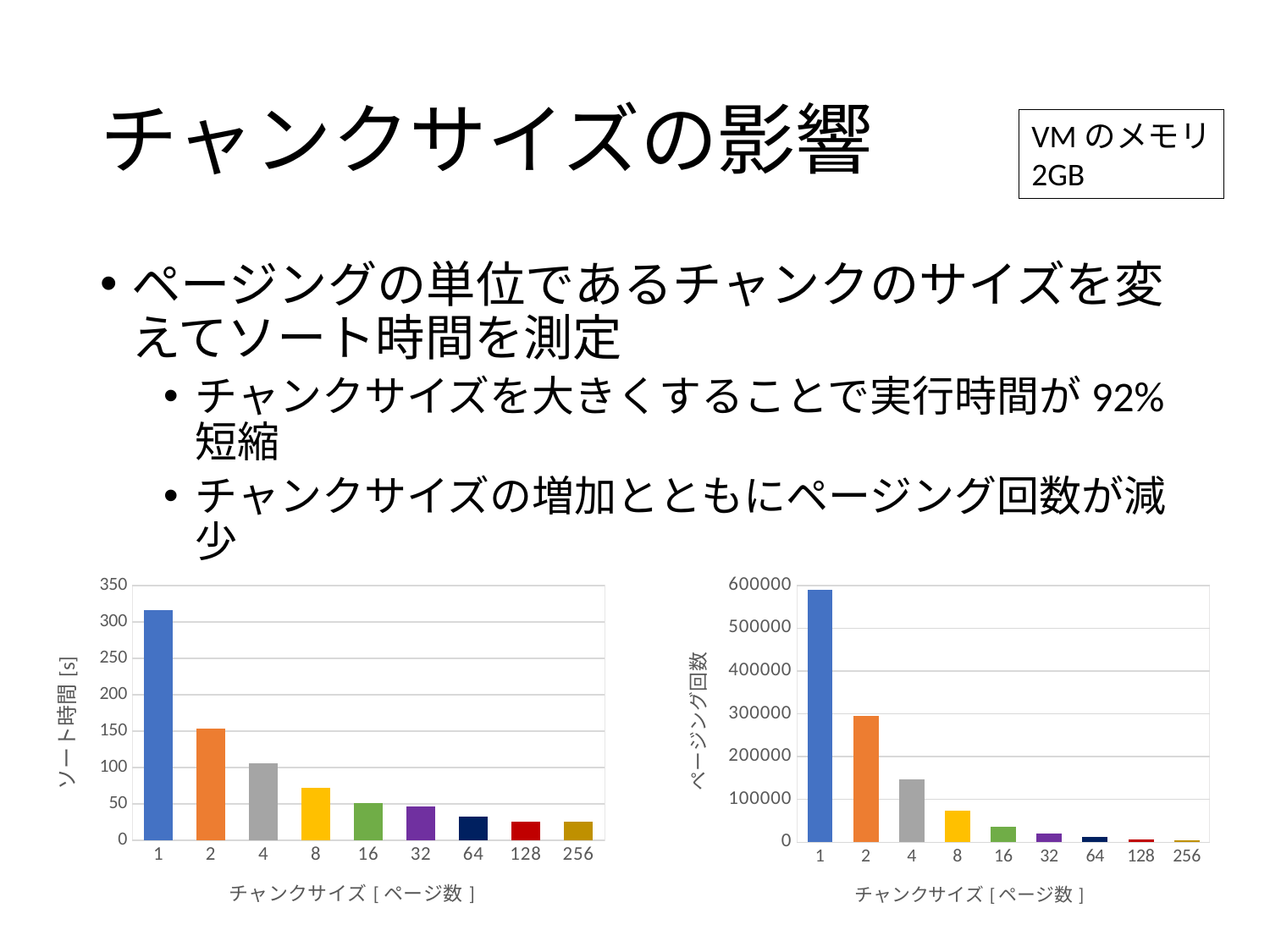
In the left chart (ソート時間 [s]), is the value for chunk size 1 greater or less than 300? greater In the right chart (ページング回数), which chunk size has the lowest paging count? 256 What is the x-axis label of the left chart? チャンクサイズ [ ページ数 ] In the right chart (ページング回数), is the value for chunk size 4 greater or less than 200000? less What kind of chart is the right chart (ページング回数)? bar chart In the left chart (ソート時間 [s]), which chunk size has the highest sort time? 1 In the right chart (ページング回数), do the values rise or fall as chunk size increases along the x axis? fall How many chunk size categories are shown on the x axis of the left chart? 9 In the left chart (ソート時間 [s]), which is larger, the value for chunk size 8 or chunk size 16? 8 In the left chart (ソート時間 [s]), is the value for chunk size 2 greater or less than 200? less